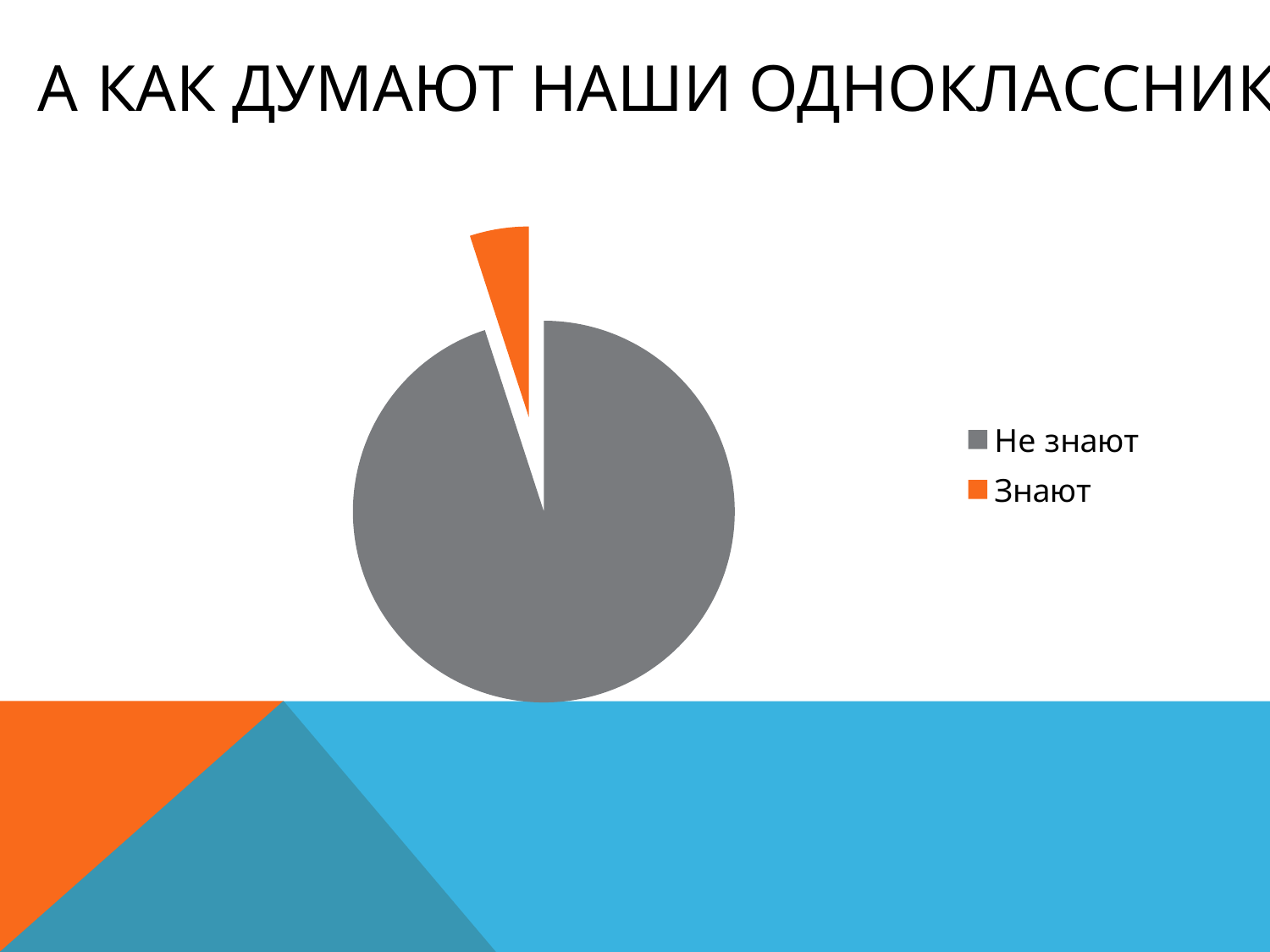
What kind of chart is shown on the slide? pie chart Which category has the largest slice in the pie chart? Не знают How many entries does the legend of the pie chart list? 2 Which category has the smallest slice in the pie chart? Знают Which slice is larger in the pie chart, "Не знают" or "Знают"? Не знают What colour is the "Знают" slice in the pie chart? orange What colour is the "Не знают" slice in the pie chart? grey How many slices does the pie chart have? 2